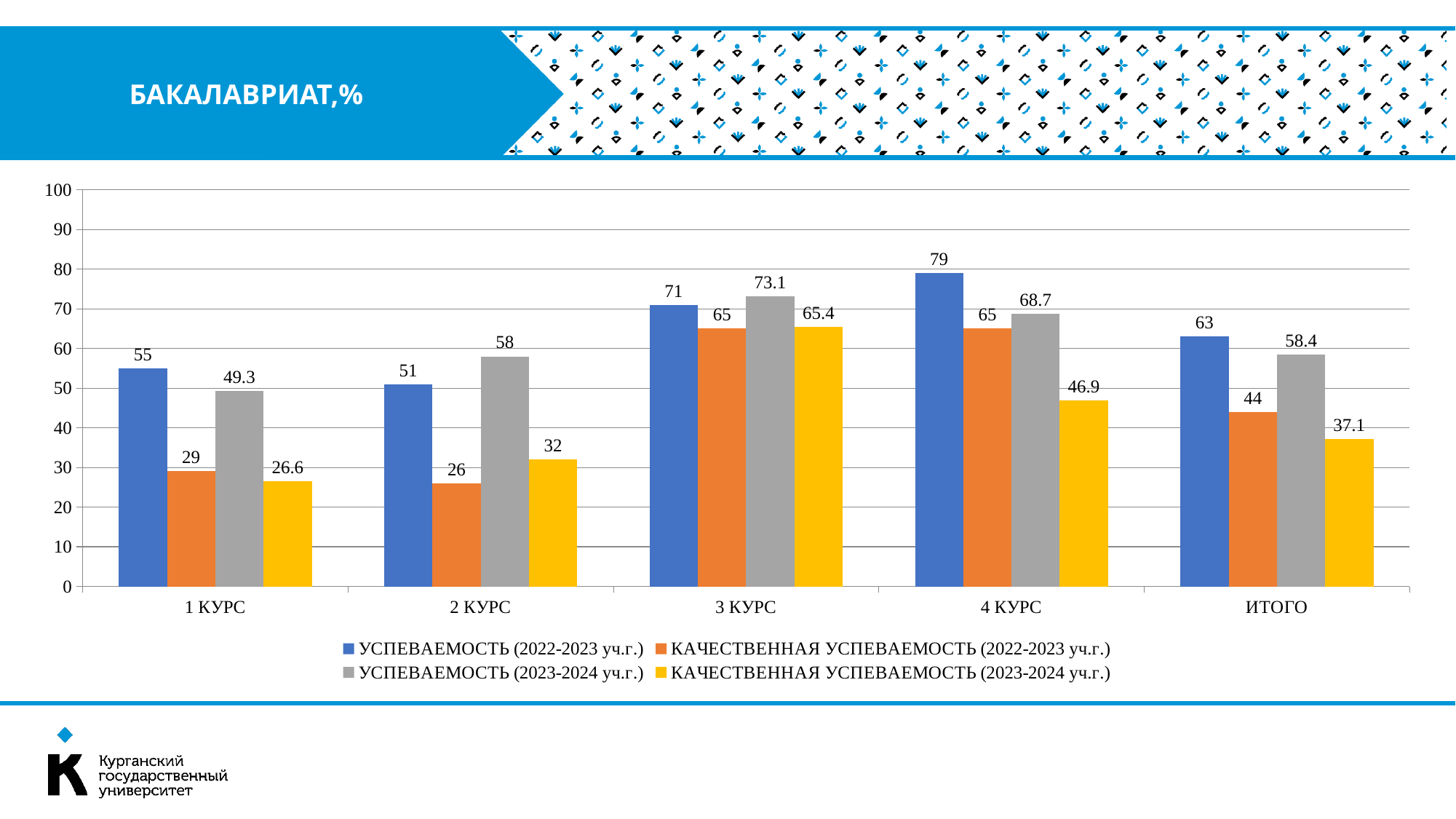
Which is larger for 4 КУРС: УСПЕВАЕМОСТЬ (2022-2023 уч.г.) or УСПЕВАЕМОСТЬ (2023-2024 уч.г.)? УСПЕВАЕМОСТЬ (2022-2023 уч.г.) What is the value of УСПЕВАЕМОСТЬ (2022-2023 уч.г.) for 3 КУРС? 71 Which category has the highest value for УСПЕВАЕМОСТЬ (2022-2023 уч.г.)? 4 КУРС What kind of chart is shown on the slide? bar chart What is the value of УСПЕВАЕМОСТЬ (2023-2024 уч.г.) for ИТОГО? 58.4 How many series does the legend list? 4 What is the title of the slide? БАКАЛАВРИАТ,% Is the value of КАЧЕСТВЕННАЯ УСПЕВАЕМОСТЬ (2023-2024 уч.г.) for 4 КУРС greater or less than 50? less What is the difference between УСПЕВАЕМОСТЬ (2023-2024 уч.г.) and УСПЕВАЕМОСТЬ (2022-2023 уч.г.) for 2 КУРС? 7 How many categories are shown on the x axis? 5 What is the value of КАЧЕСТВЕННАЯ УСПЕВАЕМОСТЬ (2023-2024 уч.г.) for 1 КУРС? 26.6 Which category has the lowest value for КАЧЕСТВЕННАЯ УСПЕВАЕМОСТЬ (2022-2023 уч.г.)? 2 КУРС